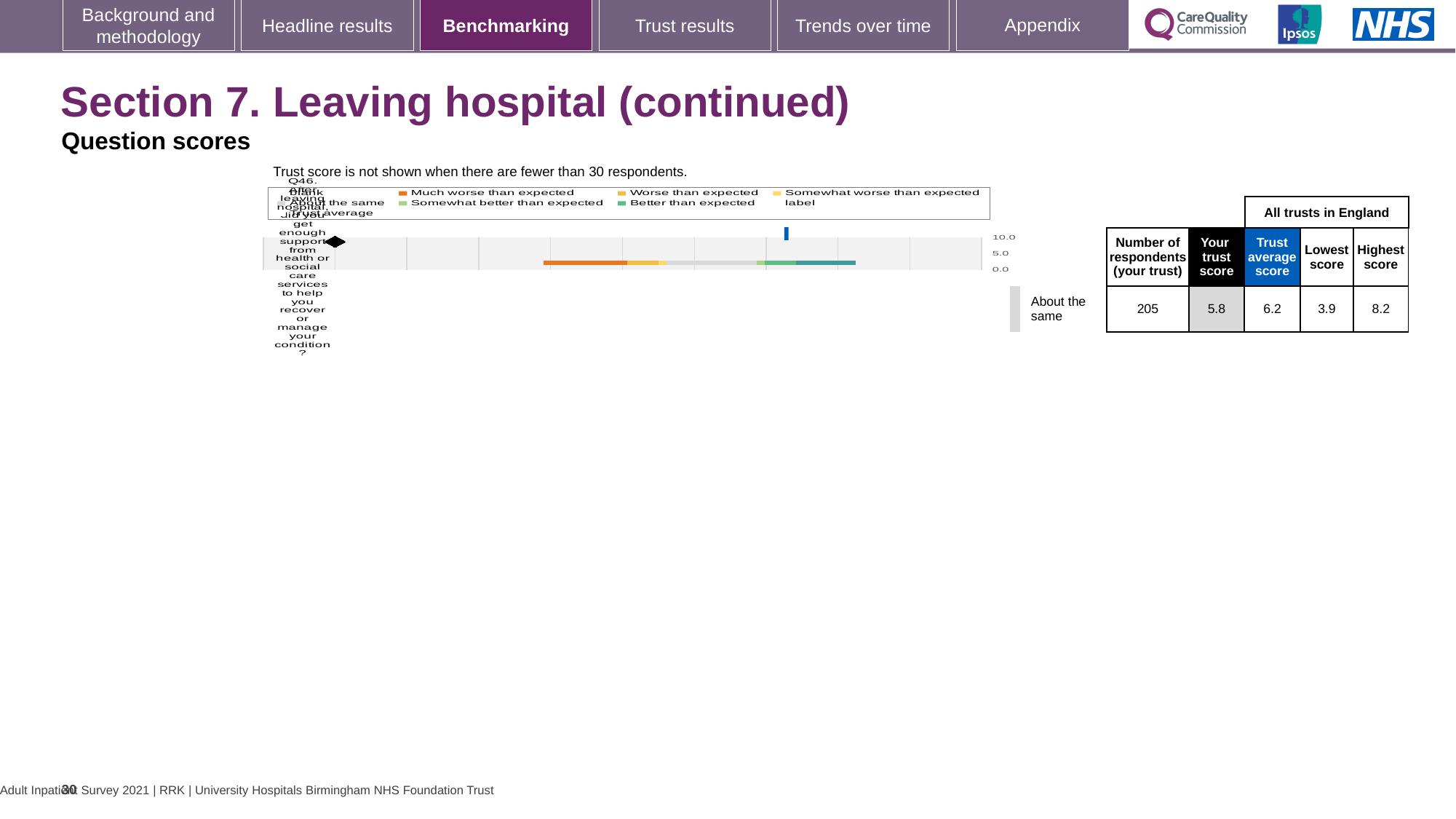
What is the lowest score among all trusts in England for Q46? 3.9 How many respondents from the trust answered Q46? 205 What is the highest score among all trusts in England for Q46? 8.2 Which benchmark category is this trust's Q46 score placed in? About the same By how much does the trust average score exceed this trust's score for Q46? 0.4 What is the highest value shown on the chart's score axis? 10.0 What is the trust average score across all trusts in England for Q46? 6.2 Which is larger for Q46: this trust's score or the trust average score? Trust average score What is the difference between the highest and lowest scores for Q46 across all trusts in England? 4.3 Is this trust's score for Q46 greater or less than 5.0? greater What is the trust score for Q46 (support from health or social care services after leaving hospital)? 5.8 What kind of chart is used to show the Q46 benchmark? Bar chart